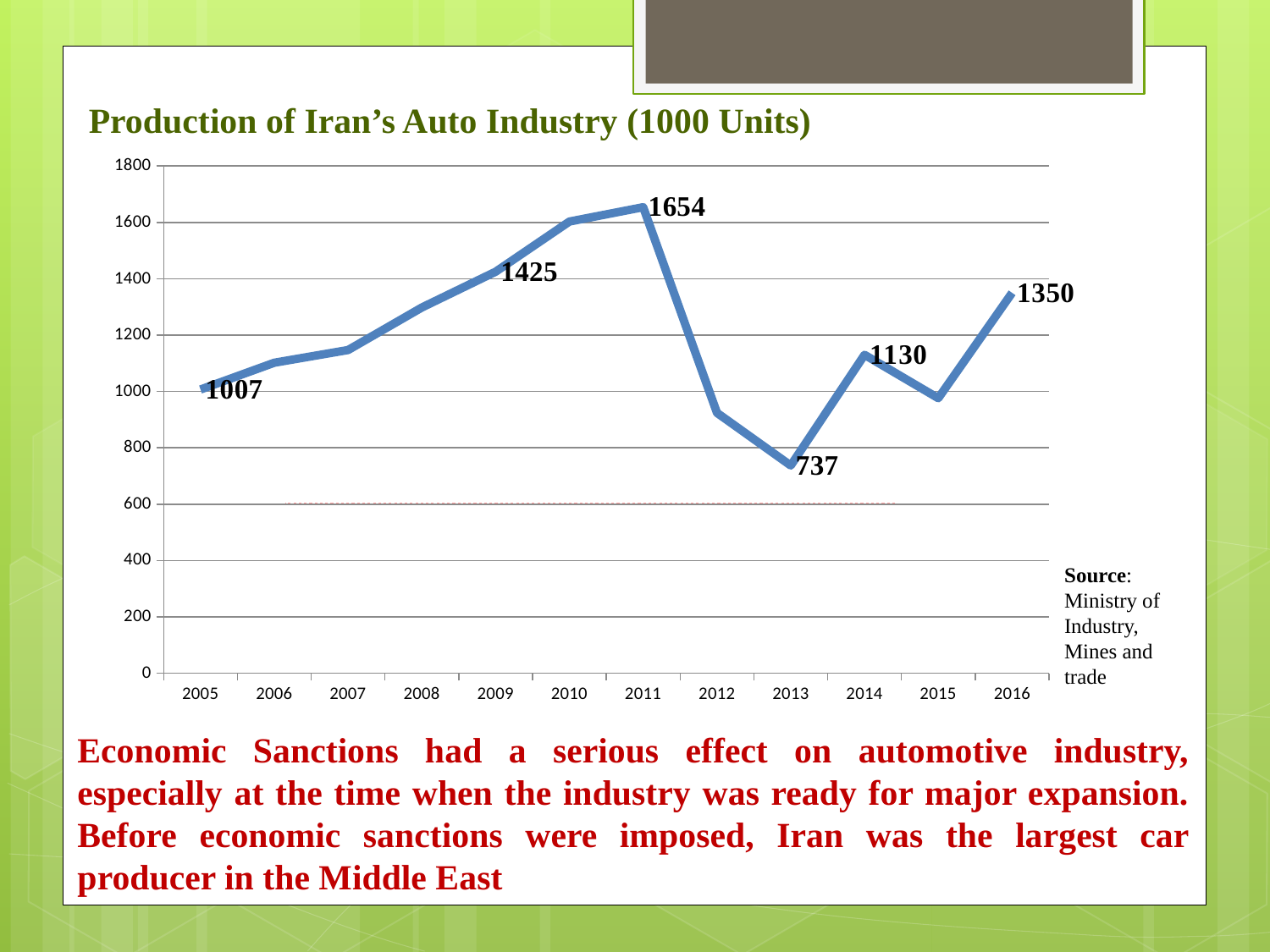
How many years are shown on the x axis? 12 Which year had higher production, 2009 or 2014? 2009 What was the production value in 2011? 1654 What was the production value in 2013? 737 What is the title of the chart? Production of Iran's Auto Industry (1000 Units) What was the production value in 2016? 1350 What is the difference between the 2011 and 2013 production values? 917 In which year was production highest? 2011 What type of chart is shown on the slide? Line chart What was the production value in 2005? 1007 In which year was production lowest? 2013 Is the production value for 2012 greater or less than 1000? less